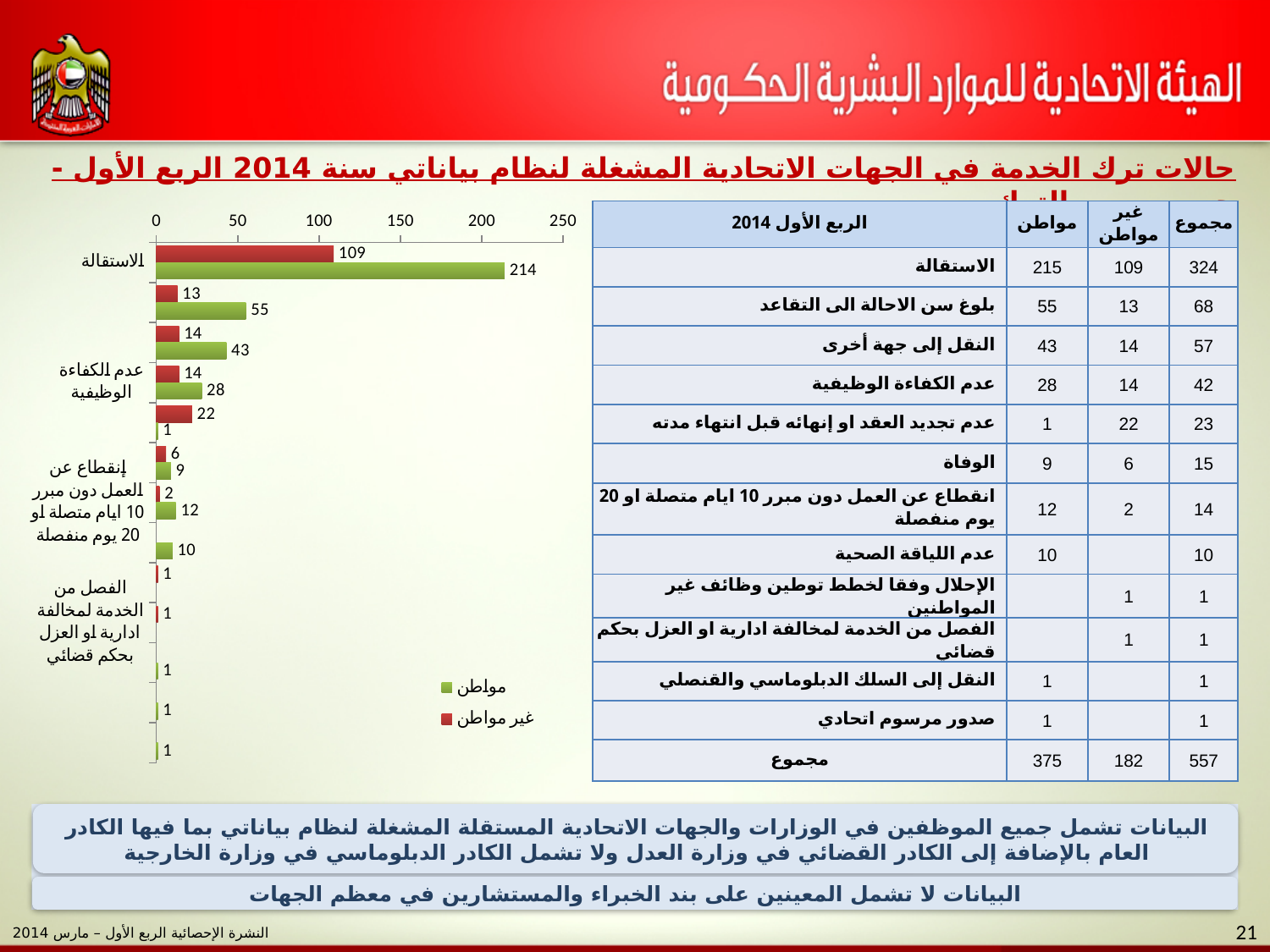
In the chart, what is the value of مواطن for عدم الكفاءة الوظيفية? 28 What kind of chart is shown on the left of the slide? bar chart In the chart, what is the difference between the مواطن and غير مواطن values for الاستقالة? 105 How many series does the chart legend list? 2 In the chart, for عدم الكفاءة الوظيفية, which series has the larger value, مواطن or غير مواطن? مواطن Which category has the highest مواطن value in the chart? الاستقالة Which colour represents the مواطن series in the chart? green In the chart, what is the value of غير مواطن for الاستقالة? 109 In the chart, what is the value of غير مواطن for عدم الكفاءة الوظيفية? 14 In the chart, what is the value of غير مواطن for إنقطاع عن العمل دون مبرر 10 ايام متصلة او 20 يوم منفصلة? 2 In the chart, what is the value of مواطن for الاستقالة? 214 In the chart, what is the value of مواطن for إنقطاع عن العمل دون مبرر 10 ايام متصلة او 20 يوم منفصلة? 12